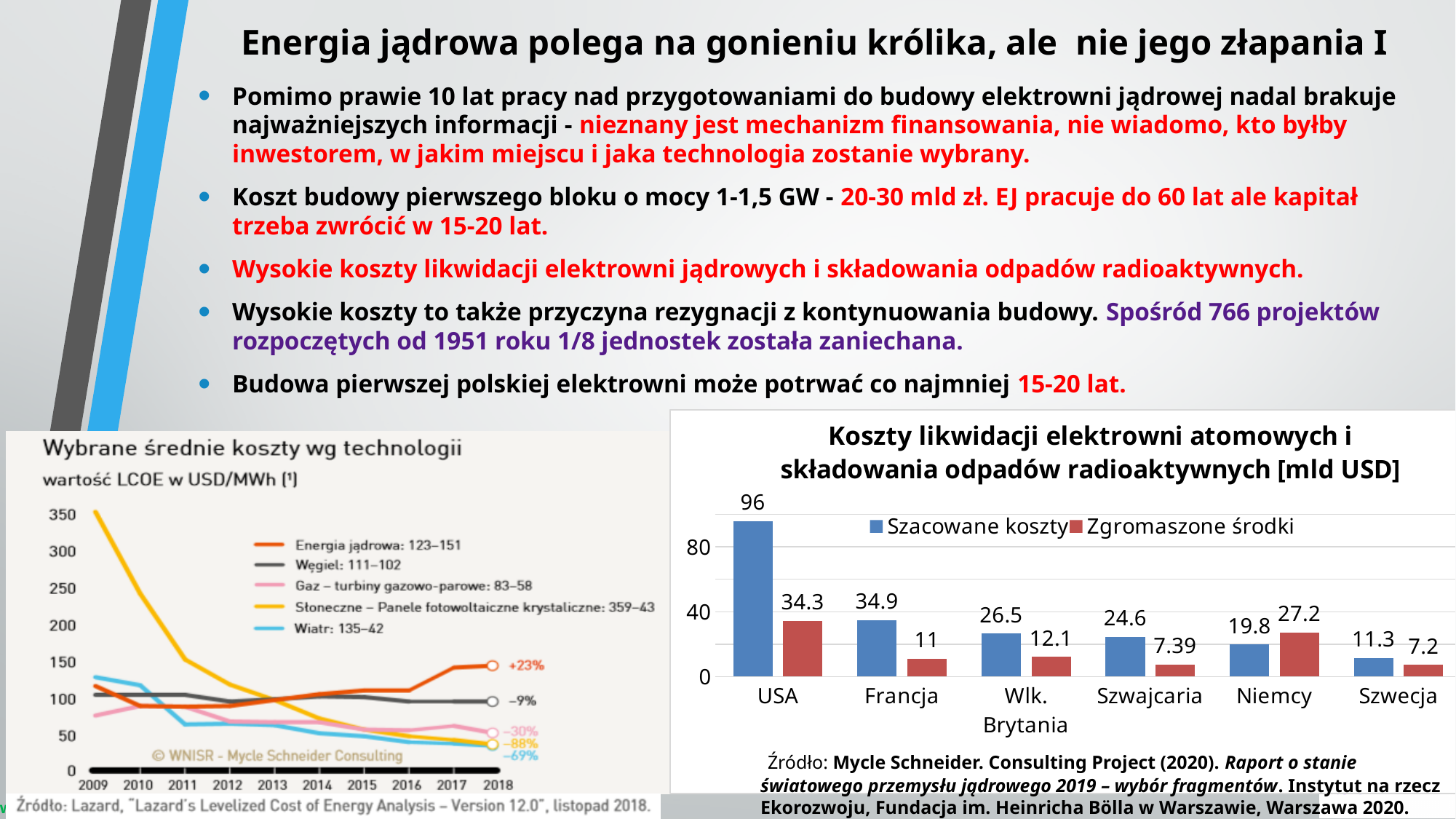
In the bar chart on the right, how many series does the legend list? 2 In the bar chart on the right, which country has the lowest Zgromaszone środki? Szwecja In the bar chart on the right, which is larger for Niemcy: Szacowane koszty or Zgromaszone środki? Zgromaszone środki In the bar chart on the right, which country has the highest Szacowane koszty? USA In the bar chart on the right, what is the difference between Szacowane koszty and Zgromaszone środki for Francja? 23.9 In the bar chart on the right, how many countries are shown on the x axis? 6 In the bar chart on the right, what is the value of Zgromaszone środki for Niemcy? 27.2 What type of chart is 'Wybrane średnie koszty wg technologii' on the left of the slide? line chart In the line chart 'Wybrane średnie koszty wg technologii', how many series does the legend list? 5 What type of chart is the chart on the right of the slide? bar chart In the line chart 'Wybrane średnie koszty wg technologii', does the Słoneczne – Panele fotowoltaiczne krystaliczne line rise or fall from 2009 to 2018? fall In the bar chart 'Koszty likwidacji elektrowni atomowych i składowania odpadów radioaktywnych', what is the value of Szacowane koszty for USA? 96